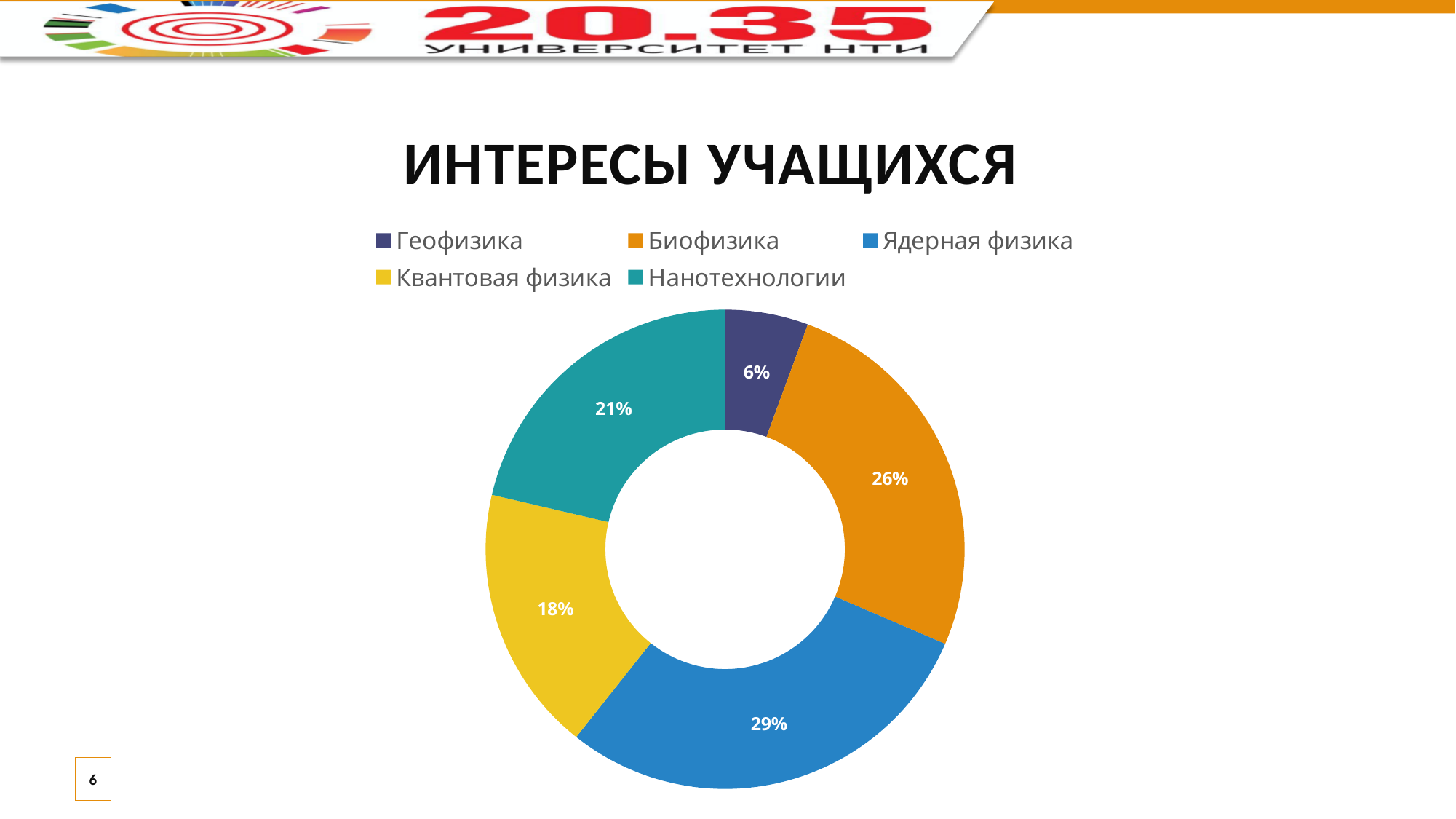
What colour represents Квантовая физика in the chart? Yellow What percentage of the chart is Нанотехнологии? 21% How many categories are shown in the chart? 5 Which has a larger share, Нанотехнологии or Биофизика? Биофизика What is the title of the chart? ИНТЕРЕСЫ УЧАЩИХСЯ What percentage of the chart is Ядерная физика? 29% What percentage of the chart is Квантовая физика? 18% What kind of chart is shown on the slide? Doughnut chart Which category has the largest share of the chart? Ядерная физика What percentage of the chart is Геофизика? 6% What is the difference in percentage points between Биофизика and Квантовая физика? 8 Which category has the smallest share of the chart? Геофизика